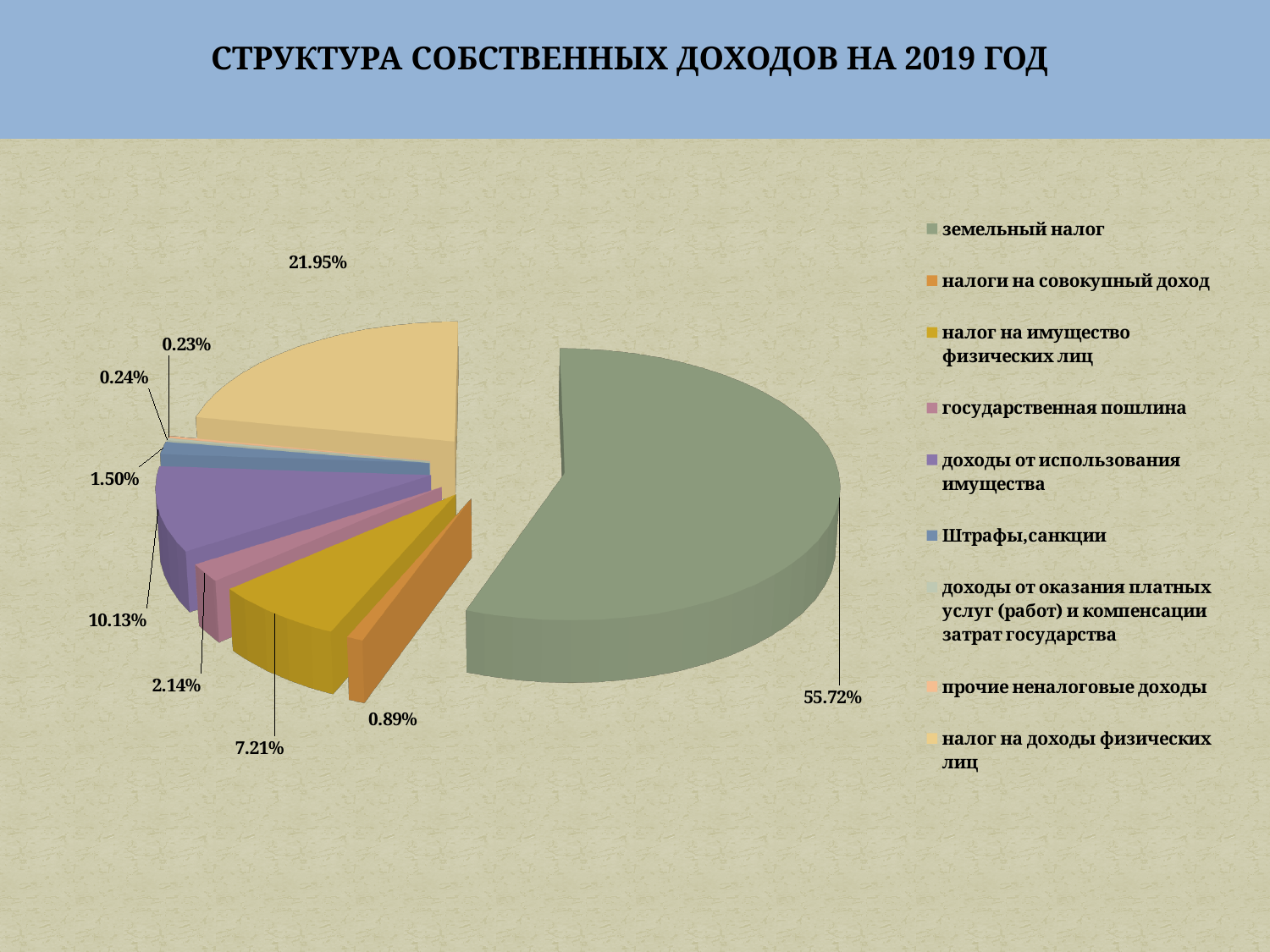
What share of the pie does налог на имущество физических лиц have? 7.21% What share of the pie does земельный налог have? 55.72% What share of the pie does доходы от использования имущества have? 10.13% What share of the pie does Штрафы,санкции have? 1.50% Which category has the largest share of the pie? земельный налог How many categories does the legend list? 9 What kind of chart is shown on the slide? pie chart Which is larger, the share of доходы от использования имущества or the share of налог на имущество физических лиц? доходы от использования имущества What share of the pie does государственная пошлина have? 2.14% What is the difference between the shares of земельный налог and налог на доходы физических лиц? 33.77% What is the title of the chart? СТРУКТУРА СОБСТВЕННЫХ ДОХОДОВ НА 2019 ГОД What share of the pie does налог на доходы физических лиц have? 21.95%